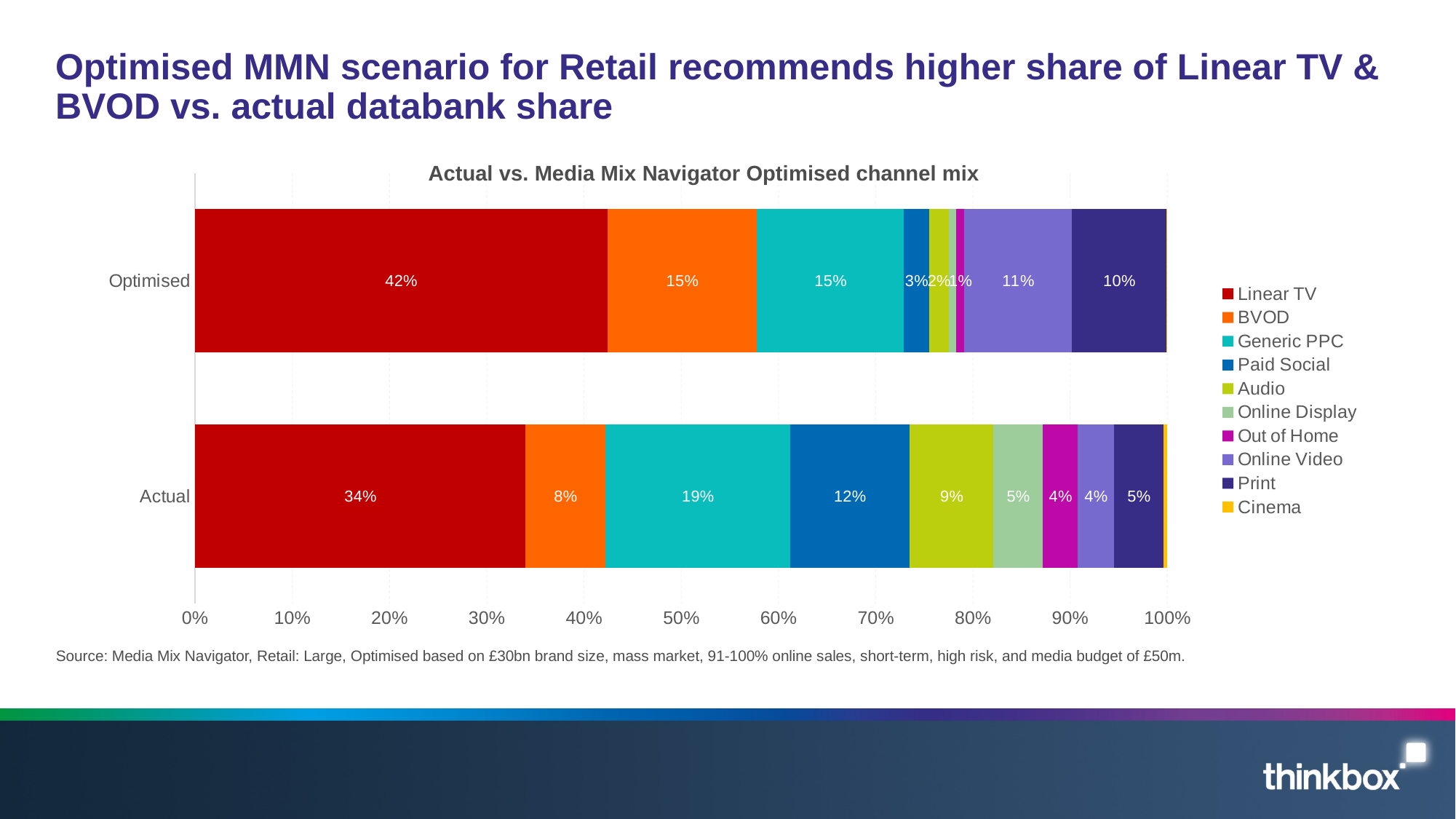
What is the Print share in the Optimised bar? 10% What is the Linear TV share in the Optimised bar? 42% How many series does the legend list? 10 What is the Linear TV share in the Actual bar? 34% What kind of chart is shown on the slide? Stacked bar chart What is the title of the chart? Actual vs. Media Mix Navigator Optimised channel mix What is the difference between the Linear TV share in the Optimised bar and in the Actual bar? 8% Which bar has the larger BVOD share, Optimised or Actual? Optimised What is the Paid Social share in the Actual bar? 12% How many bars (categories) are plotted on the chart? 2 What is the Generic PPC share in the Actual bar? 19% What is the BVOD share in the Actual bar? 8%